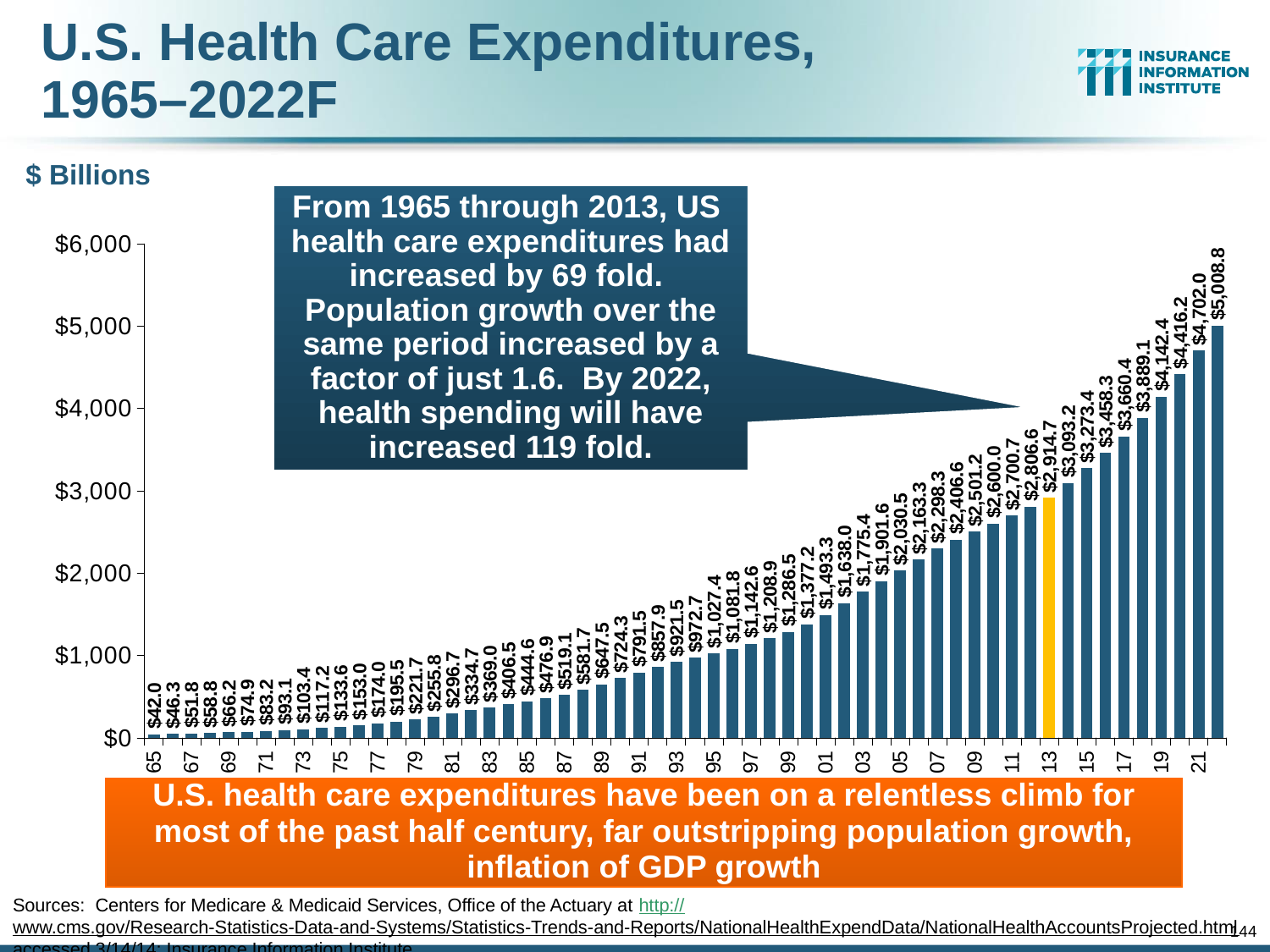
What kind of chart is shown on the slide? bar chart What is the value shown for 2022F (the last bar)? $5,008.8 What is the value of the orange highlighted bar (2013)? $2,914.7 Do the values generally rise or fall from 1965 to 2022 along the x axis? rise Which is larger, the value for 2013 or the value for 2022F? 2022F What unit is stated for the y axis of the chart? $ Billions Which year has the lowest health care expenditure value on the chart? 1965 (65) What is the difference between the 2022F value and the 1965 value? $4,966.8 Which year has the highest health care expenditure value on the chart? 2022 (22) Is the value for 2013 (the orange bar) greater or less than $3,000? less What is the value shown for 1965 (the first bar)? $42.0 What is the difference between the 2022F value and the 2013 value? $2,094.1